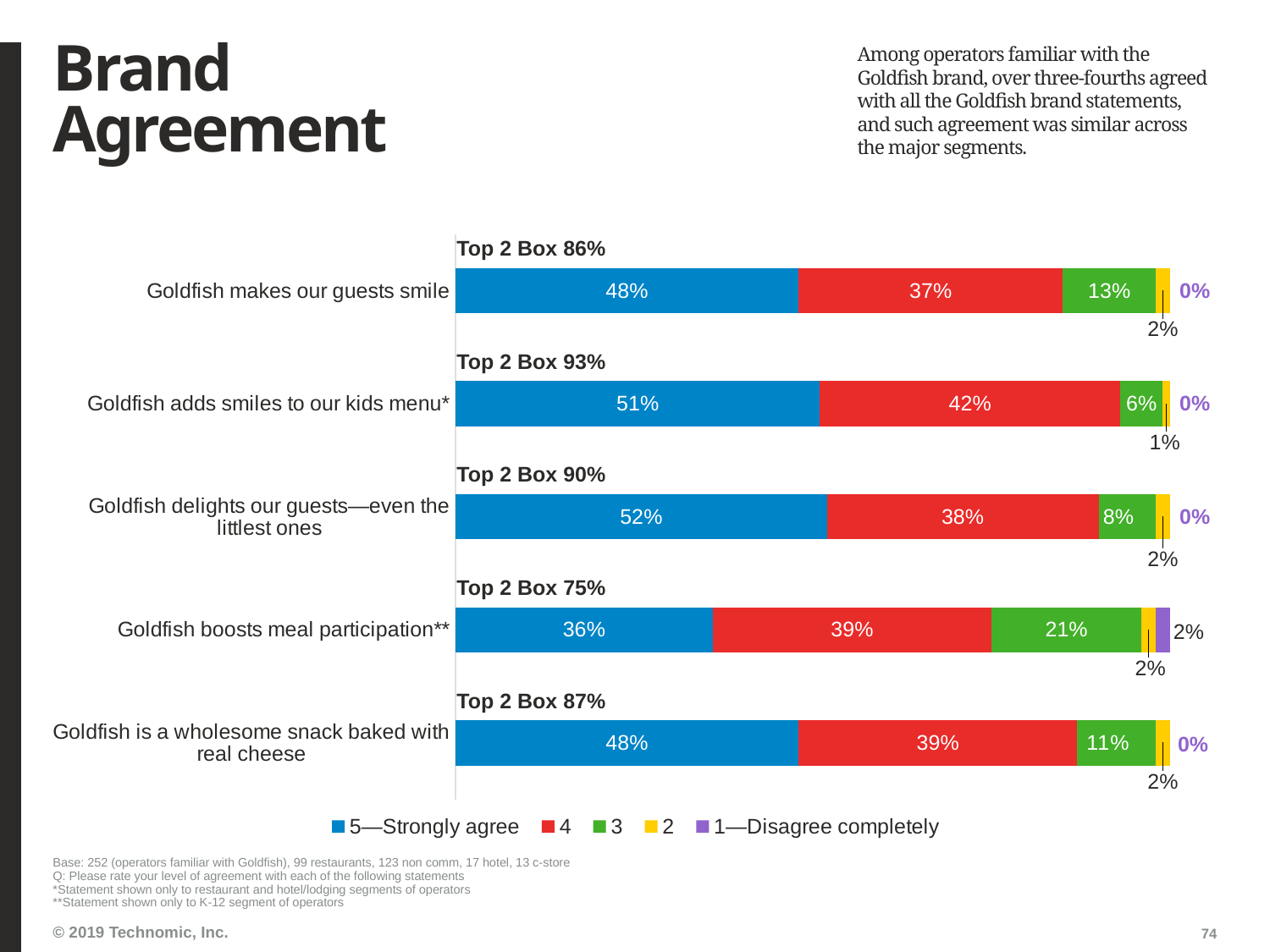
What kind of chart is shown on the slide? Stacked bar chart What is the Top 2 Box score for "Goldfish adds smiles to our kids menu"? 93% How many brand statements are shown in the chart? 5 Which statement has the lowest percentage of 5—Strongly agree responses? Goldfish boosts meal participation How many series does the legend list? 5 What percentage of operators strongly agree (5) that Goldfish makes our guests smile? 48% What percentage rated "Goldfish boosts meal participation" as 1—Disagree completely? 2% Which statement has the highest Top 2 Box score? Goldfish adds smiles to our kids menu Which is larger: the 5—Strongly agree share for "Goldfish delights our guests—even the littlest ones" or for "Goldfish makes our guests smile"? Goldfish delights our guests—even the littlest ones What percentage rated "Goldfish is a wholesome snack baked with real cheese" a 4? 39% What percentage rated "Goldfish boosts meal participation" a 3? 21% What is the difference between the Top 2 Box scores for "Goldfish adds smiles to our kids menu" and "Goldfish boosts meal participation"? 18%